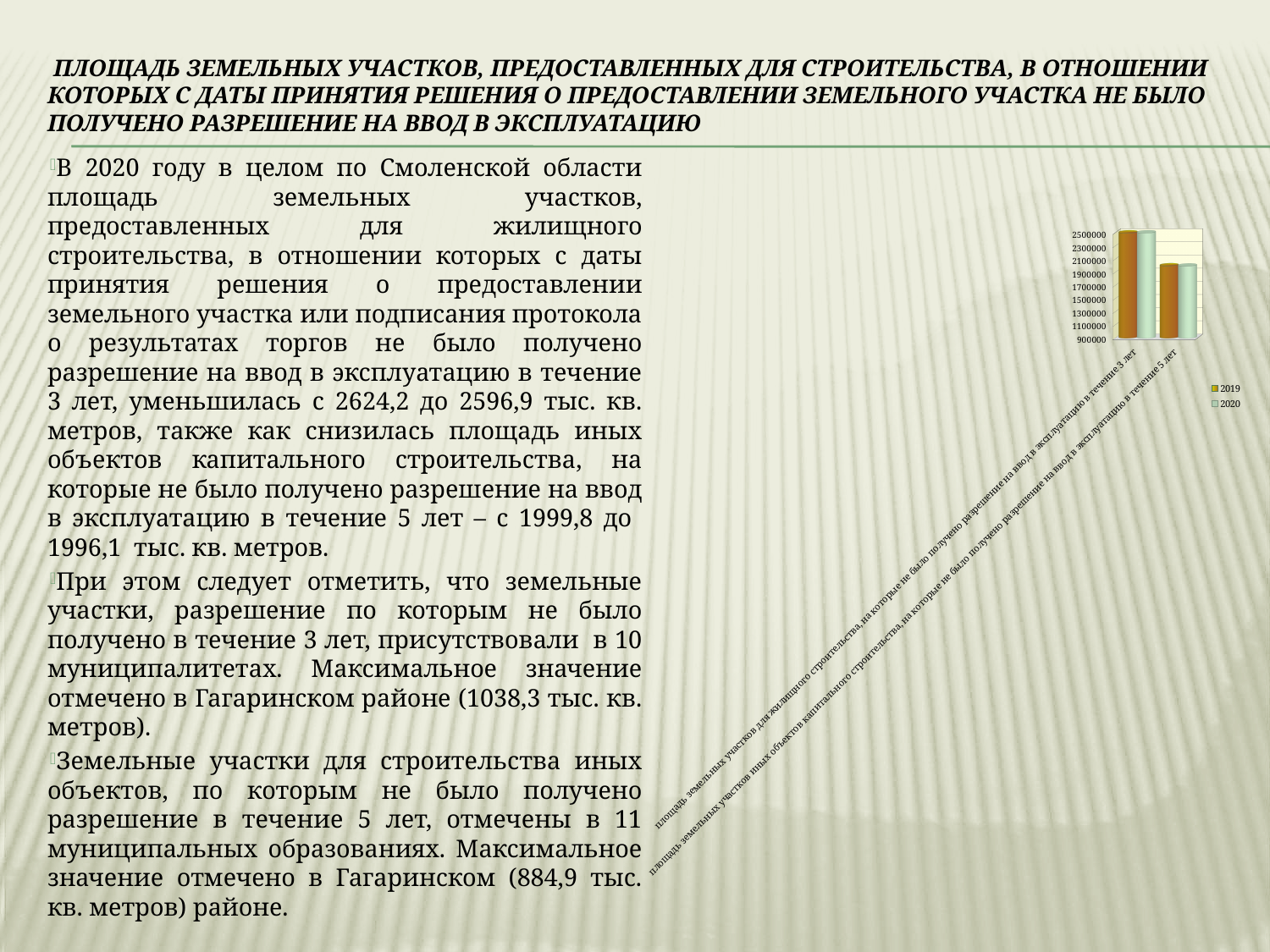
Is the 2020 value for the other capital construction objects (5 years) category greater or less than 2300000? less Which category has the highest bars on the chart? площадь земельных участков для жилищного строительства, на которые не было получено разрешение на ввод в эксплуатацию в течение 3 лет What kind of chart is shown on the slide? bar chart Which is larger in 2020: the value for the housing construction (3 years) category or the value for the other capital construction objects (5 years) category? housing construction (3 years) What is the highest tick value shown on the chart's vertical axis? 2500000 How many categories are plotted on the chart's x axis? 2 Do the values rise or fall from the first category to the second category along the x axis? fall How many series does the chart legend list? 2 Which years are listed in the chart legend? 2019 and 2020 Is the 2019 value for the housing construction (3 years) category greater or less than 2300000? greater Which category has the lowest bars on the chart? площадь земельных участков иных объектов капитального строительства, на которые не было получено разрешение на ввод в эксплуатацию в течение 5 лет Is the 2020 value for the other capital construction objects (5 years) category greater or less than 1700000? greater